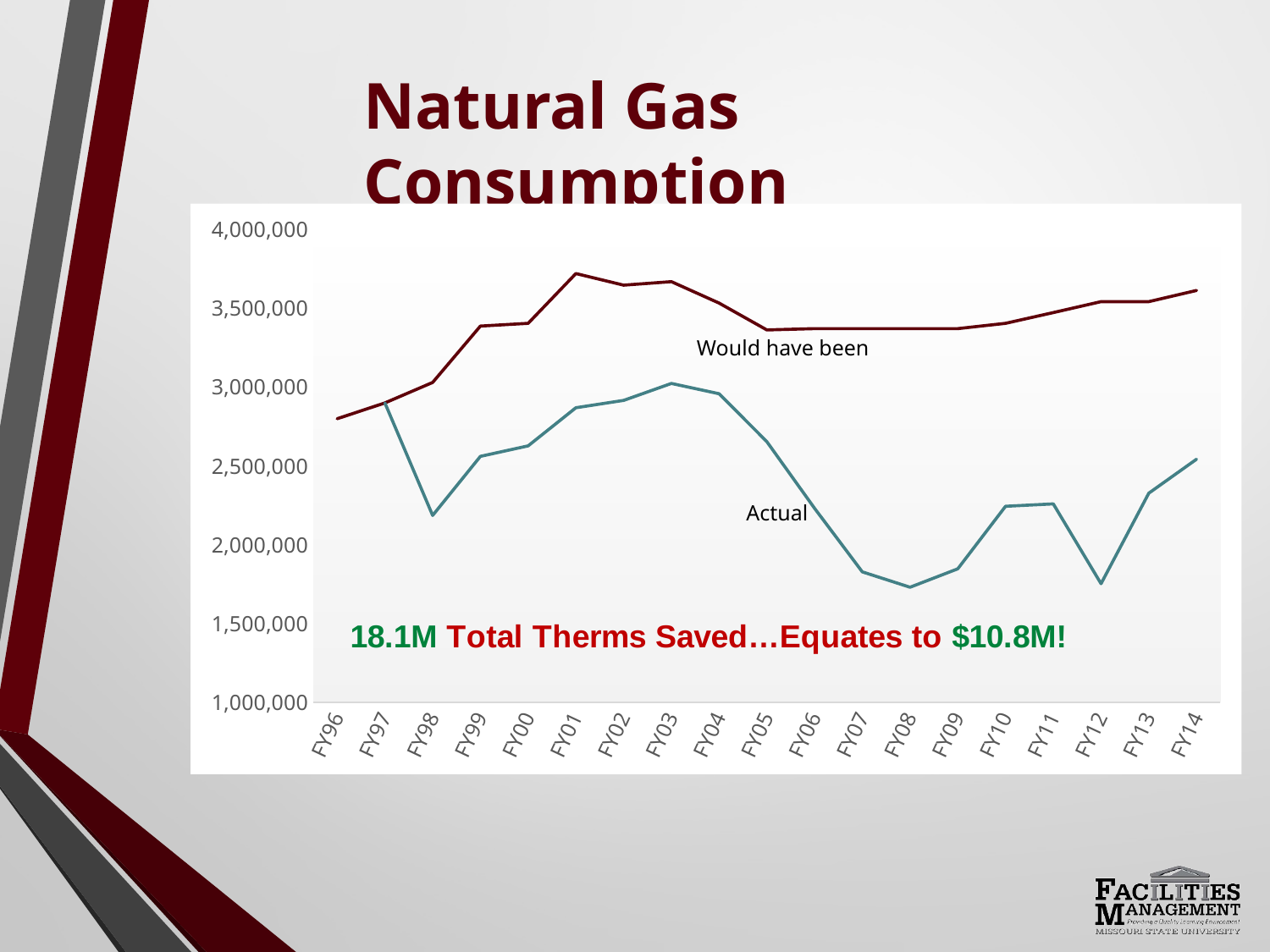
Is the Actual value for FY07 greater or less than 2,000,000? less Is the Actual value for FY10 greater or less than 2,000,000? greater Is the Actual value for FY98 greater or less than 2,500,000? less Does the Actual line rise or fall from FY04 to FY08? Fall What are the names of the two lines labelled in the chart? Would have been and Actual How many fiscal years are plotted along the x axis? 19 How many data series are plotted in the chart? 2 What kind of chart is shown on the slide? Line chart In FY08, which line has the larger value, Would have been or Actual? Would have been What is the title of the chart on the slide? Natural Gas Consumption